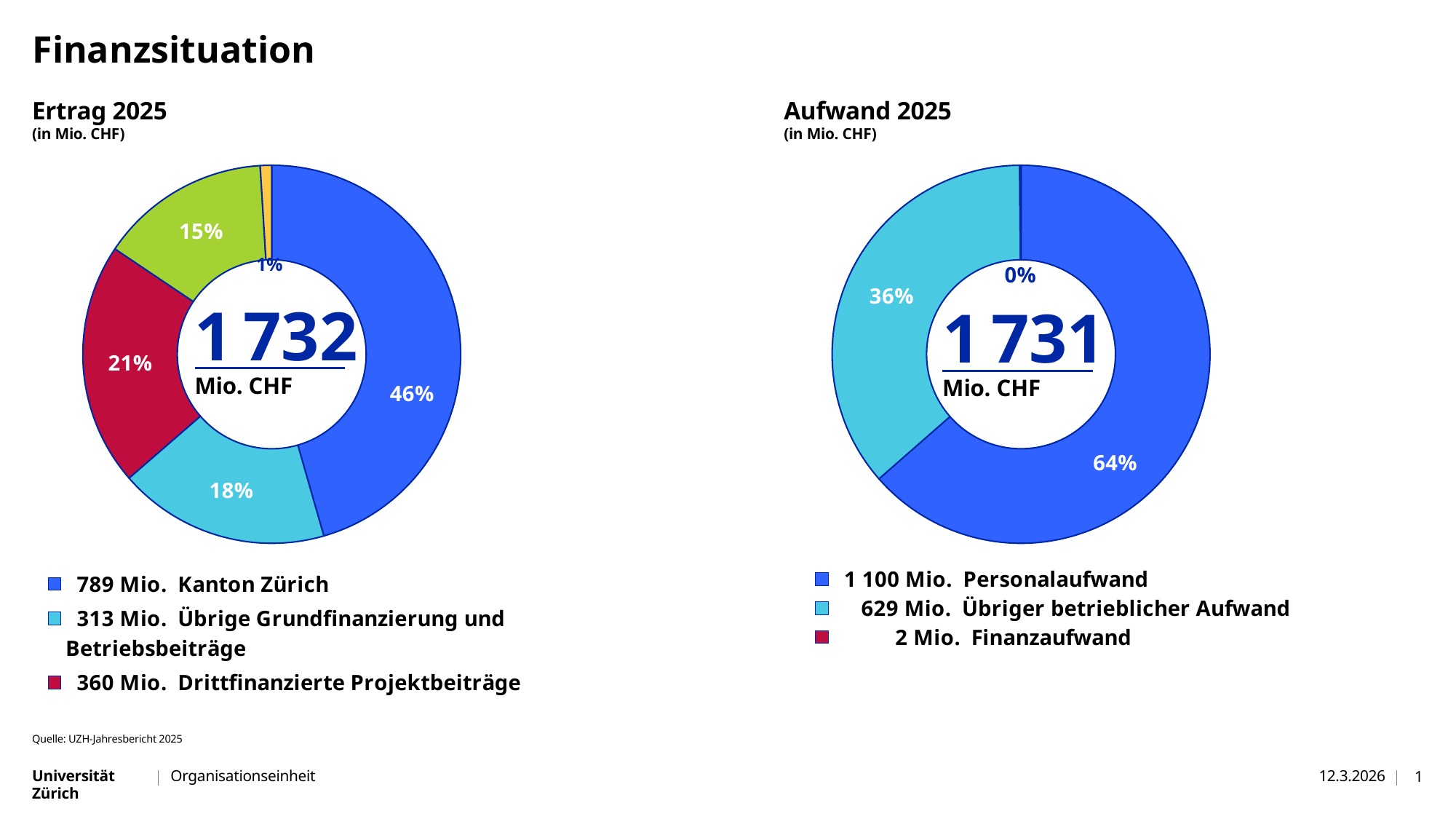
In the Ertrag 2025 chart, what is the total shown in the centre of the donut? 1 732 Mio. CHF In the Aufwand 2025 chart, what is the value for Personalaufwand? 1 100 Mio. In the Aufwand 2025 chart, which category has the smallest value? Finanzaufwand What kind of chart is used for Aufwand 2025? Donut (pie) chart In the Ertrag 2025 chart, what is the difference between Drittfinanzierte Projektbeiträge and Übrige Grundfinanzierung und Betriebsbeiträge? 47 Mio. In the Ertrag 2025 chart, what share of the total does Kanton Zürich represent? 46% In the Ertrag 2025 chart, what is the value for Kanton Zürich? 789 Mio. In the Aufwand 2025 chart, what share does Übriger betrieblicher Aufwand represent? 36% In the Ertrag 2025 chart, what is the value for Drittfinanzierte Projektbeiträge? 360 Mio. In the Ertrag 2025 chart, which legend category has the largest value? Kanton Zürich In the Ertrag 2025 chart, what share does Übrige Grundfinanzierung und Betriebsbeiträge represent? 18% In the Aufwand 2025 chart, how many categories does the legend list? 3